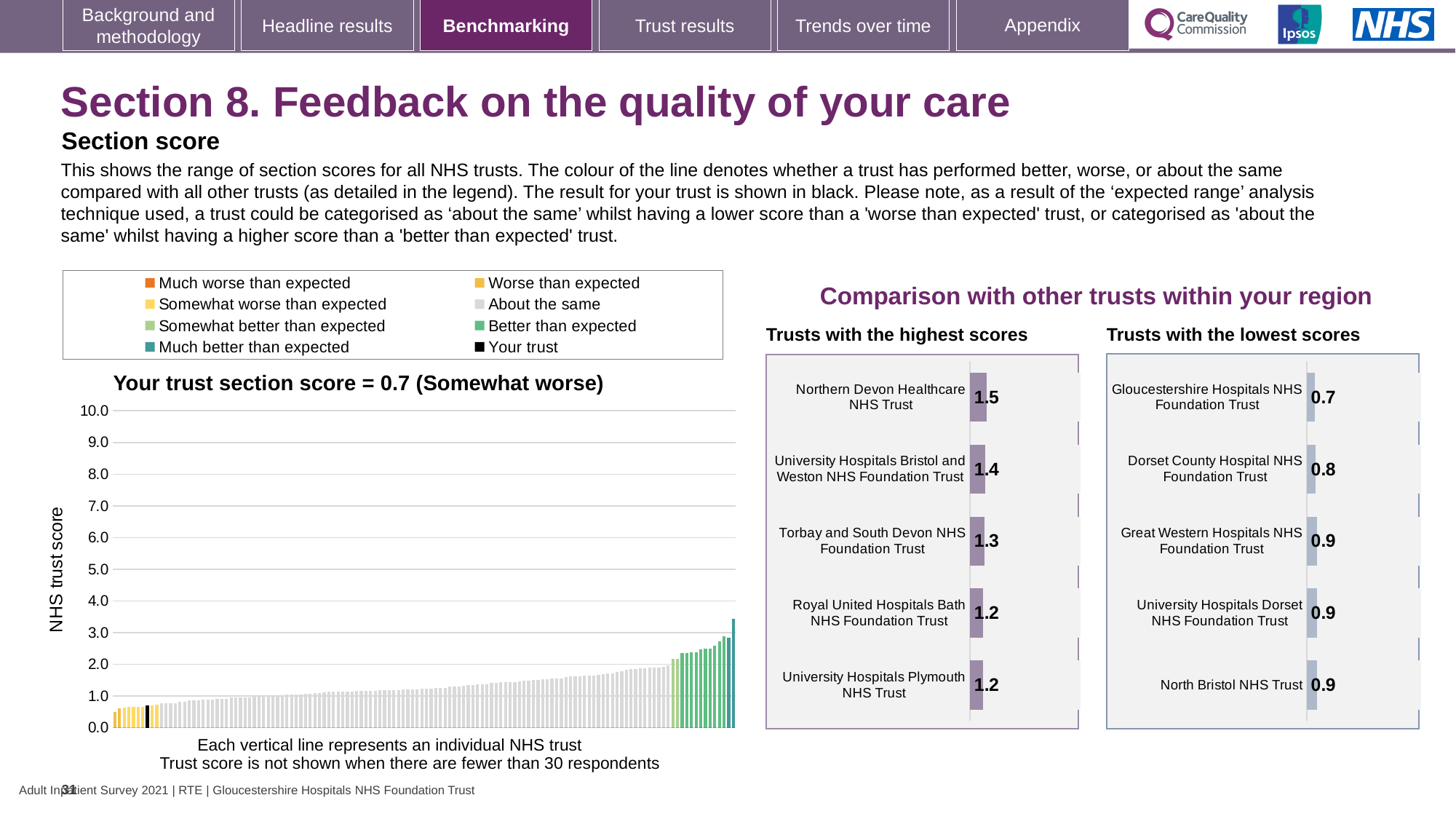
In the 'Trusts with the lowest scores' chart, what is the score for North Bristol NHS Trust? 0.9 In the 'Trusts with the highest scores' chart, which trust has the highest score? Northern Devon Healthcare NHS Trust In the main chart on the left, do the trust scores rise or fall from left to right? rise What kind of chart is the main chart on the left showing NHS trust scores? bar chart How many trusts are shown in the 'Trusts with the highest scores' chart? 5 In the 'Trusts with the highest scores' chart, which has the larger score: University Hospitals Bristol and Weston NHS Foundation Trust or Royal United Hospitals Bath NHS Foundation Trust? University Hospitals Bristol and Weston NHS Foundation Trust In the 'Trusts with the highest scores' chart, what is the difference between the scores of Northern Devon Healthcare NHS Trust and Torbay and South Devon NHS Foundation Trust? 0.2 In the 'Trusts with the lowest scores' chart, which trust has the lowest score? Gloucestershire Hospitals NHS Foundation Trust How many entries does the legend above the main chart on the left list? 8 According to the title of the main chart on the left, what is your trust's section score? 0.7 In the 'Trusts with the lowest scores' chart, what is the score for Dorset County Hospital NHS Foundation Trust? 0.8 In the 'Trusts with the highest scores' chart, what is the score for Northern Devon Healthcare NHS Trust? 1.5